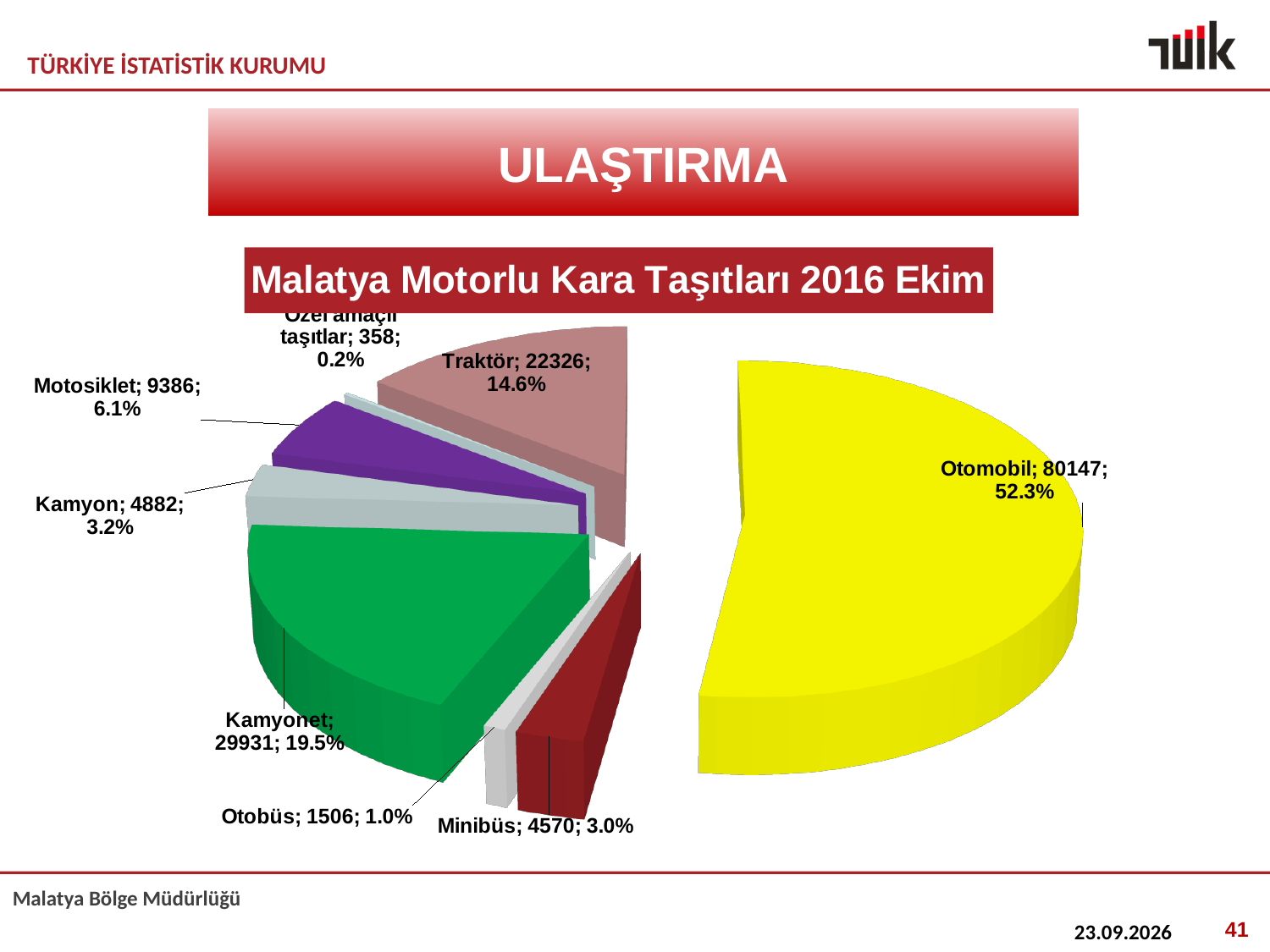
What is the difference between the values for Kamyon and Minibüs? 312 What share of the pie does Otomobil represent? 52.3% Which category has the smallest slice? Özel amaçlı taşıtlar What is the title of the chart? Malatya Motorlu Kara Taşıtları 2016 Ekim What is the value for Otomobil? 80147 What type of chart is shown on the slide? Pie chart What is the value for Otobüs? 1506 What is the value for Kamyonet? 29931 Which category has the largest slice? Otomobil Which is larger, the value for Motosiklet or the value for Kamyon? Motosiklet What share of the pie does Traktör represent? 14.6% How many categories (slices) does the pie chart have? 8